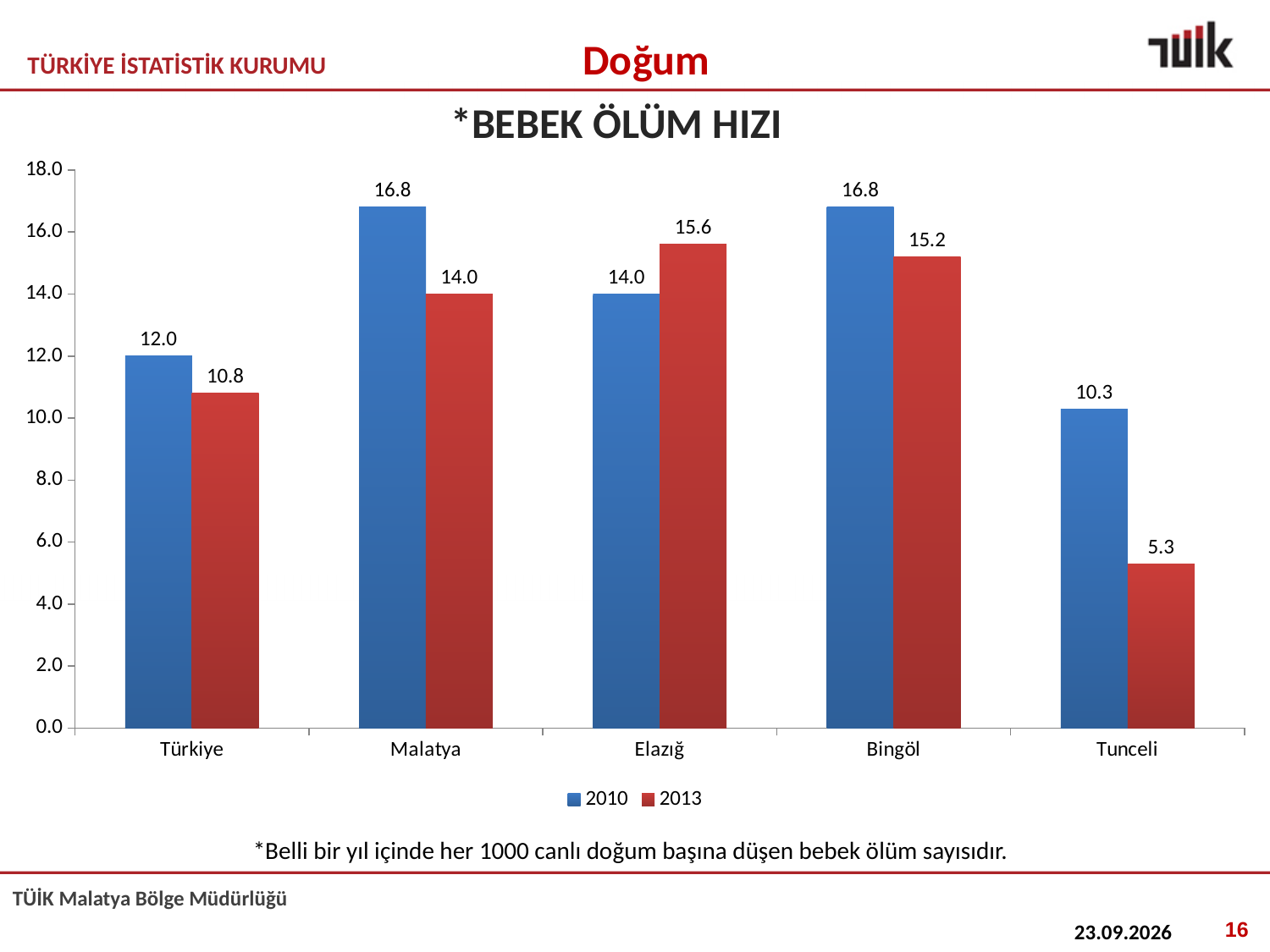
How many series does the legend list? 2 Which colour represents the 2013 series? Red What kind of chart is shown on the slide? Bar chart Which category has the highest 2013 value? Elazığ How many categories are shown on the x axis? 5 Which is larger for Elazığ, the 2010 value or the 2013 value? 2013 What is the 2013 value for Elazığ? 15.6 What is the 2013 value for Tunceli? 5.3 What is the 2010 value for Malatya? 16.8 Which category has the lowest 2013 value? Tunceli What is the difference between the 2010 and 2013 values for Bingöl? 1.6 What is the title of the chart? *BEBEK ÖLÜM HIZI